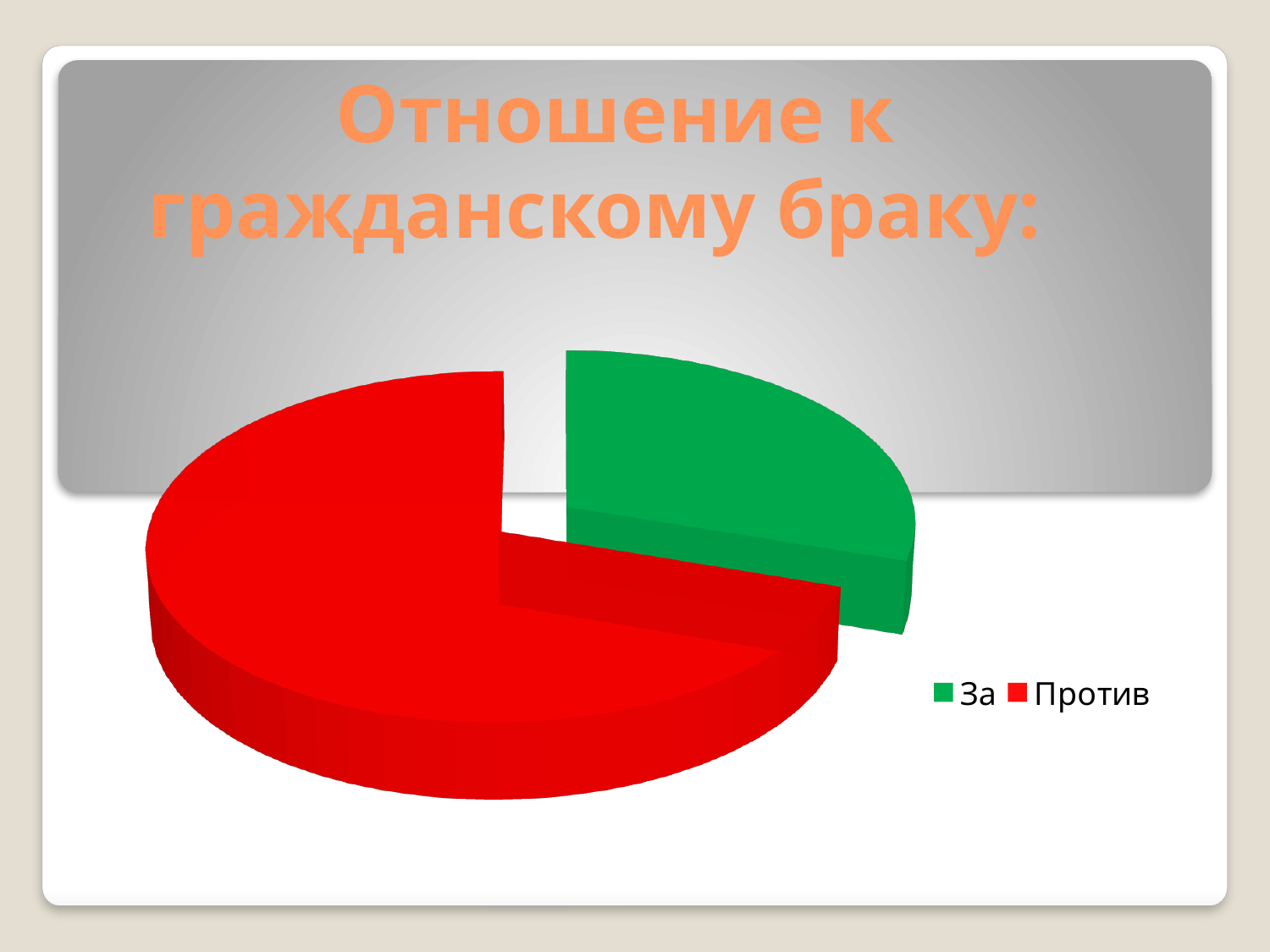
Which slice is larger, За or Против? Против What is the title of the chart on the slide? Отношение к гражданскому браку: Which category has the largest slice of the pie? Против How many slices does the pie chart have? 2 Which category has the smallest slice of the pie? За What colour is the slice for За? green How many entries does the legend list? 2 What kind of chart is shown on the slide? pie chart